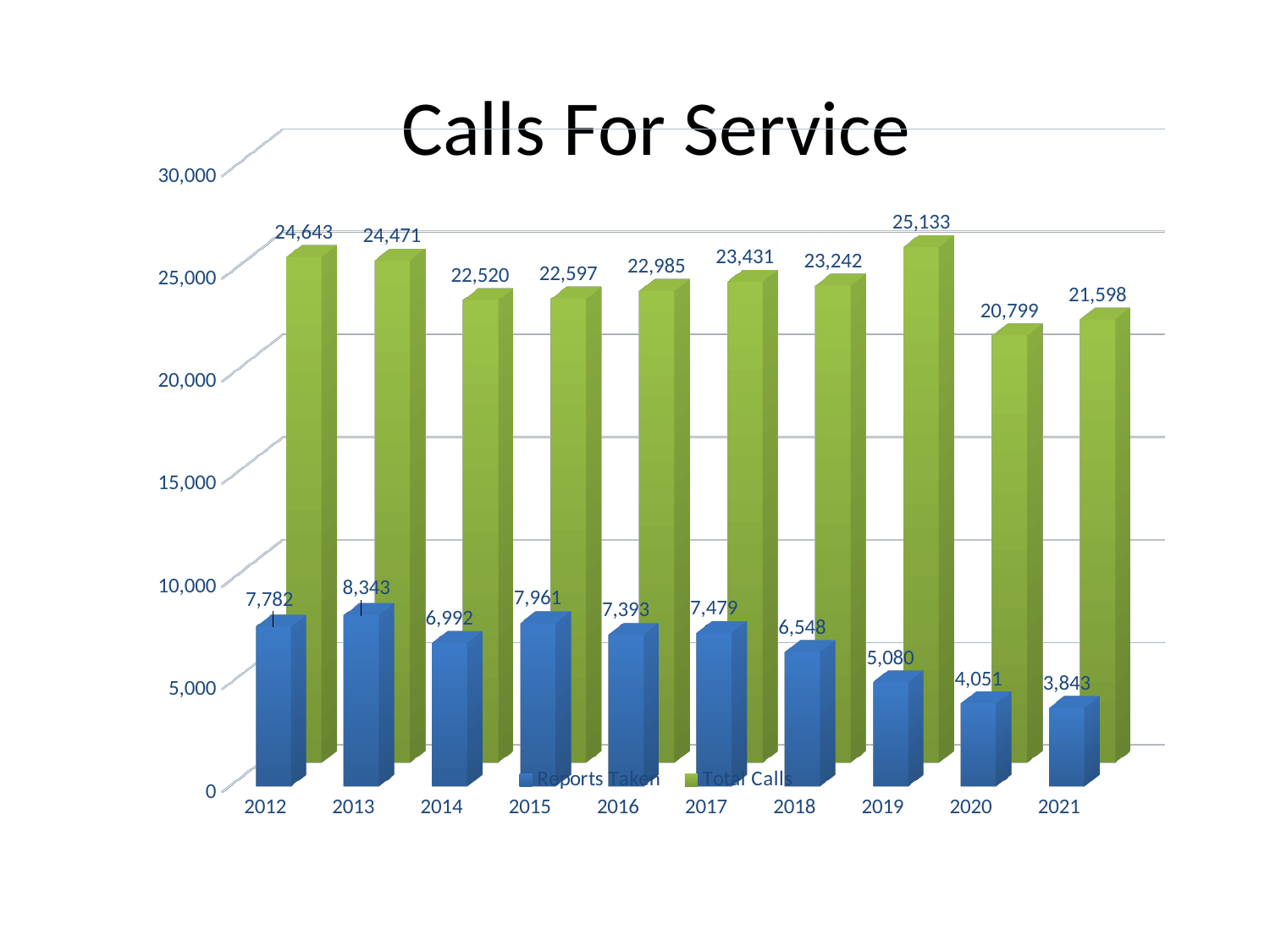
Which year has the highest Total Calls value? 2019 What kind of chart is shown on the slide? bar chart What is the Total Calls value for 2019? 25,133 What is the Reports Taken value for 2014? 6,992 How many years are shown on the x axis? 10 What is the difference between Total Calls in 2012 and Total Calls in 2021? 3,045 Is the Total Calls value for 2020 greater or less than 25,000? less What is the title of the chart? Calls For Service Which year has the lowest Total Calls value? 2020 Which year has the lowest Reports Taken value? 2021 How many series does the legend list? 2 Which is larger: Reports Taken in 2013 or Reports Taken in 2015? Reports Taken in 2013